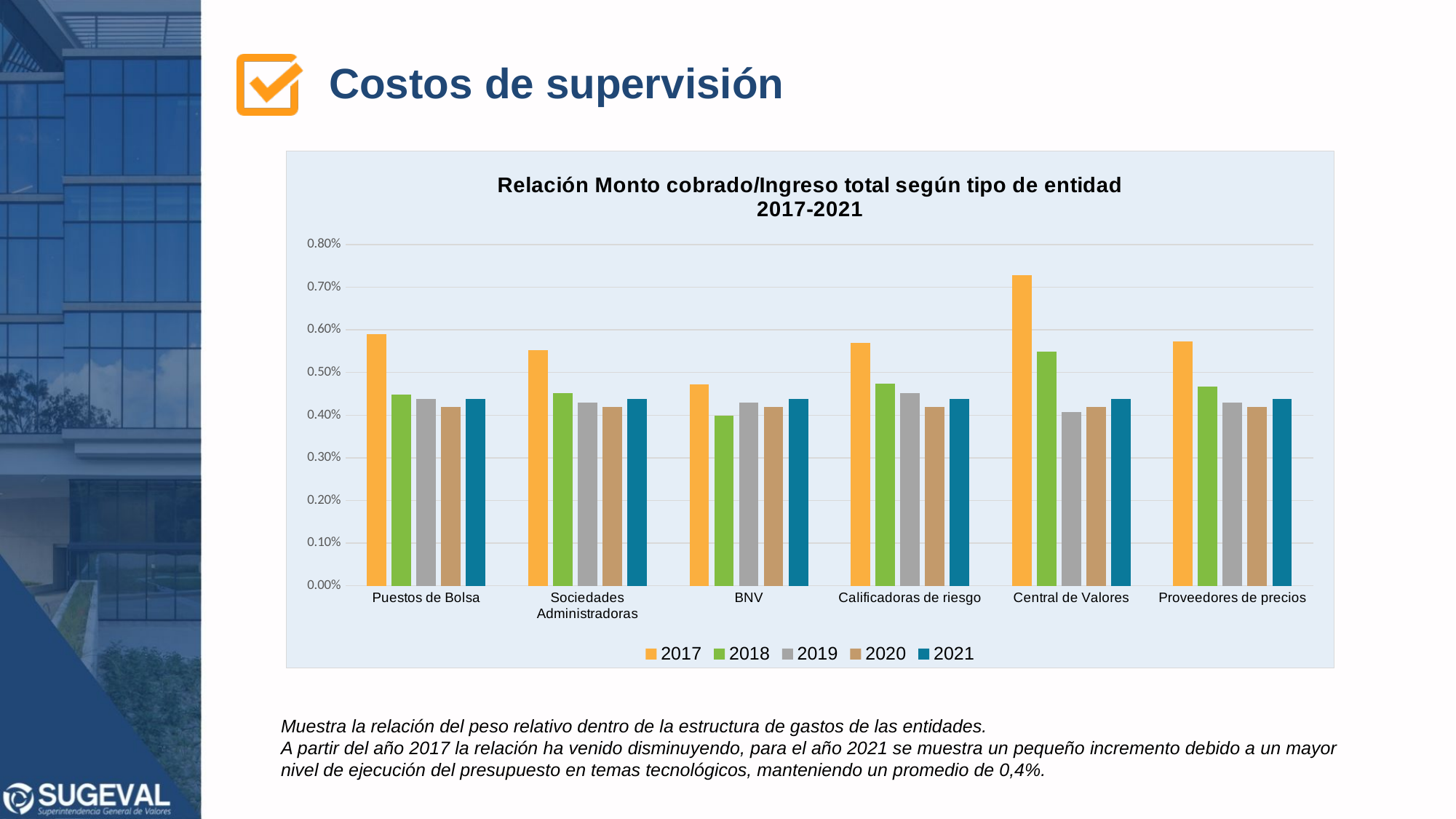
Which is larger: the 2017 value for Central de Valores or the 2017 value for Puestos de Bolsa? Central de Valores For Central de Valores, do the bars rise or fall from 2017 to 2020? fall How many series does the legend list? 5 How many entity types (categories) are shown on the x axis? 6 Which entity type has the highest value for 2018? Central de Valores What is the title of the chart? Relación Monto cobrado/Ingreso total según tipo de entidad 2017-2021 Which entity type has the lowest value for 2017? BNV Is the 2018 value for BNV greater or less than 0.50%? less Which is larger: the 2018 value for Central de Valores or the 2018 value for BNV? Central de Valores What kind of chart is shown on the slide? Bar chart Which entity type has the highest value for 2017? Central de Valores Is the 2017 value for Central de Valores greater or less than 0.70%? greater